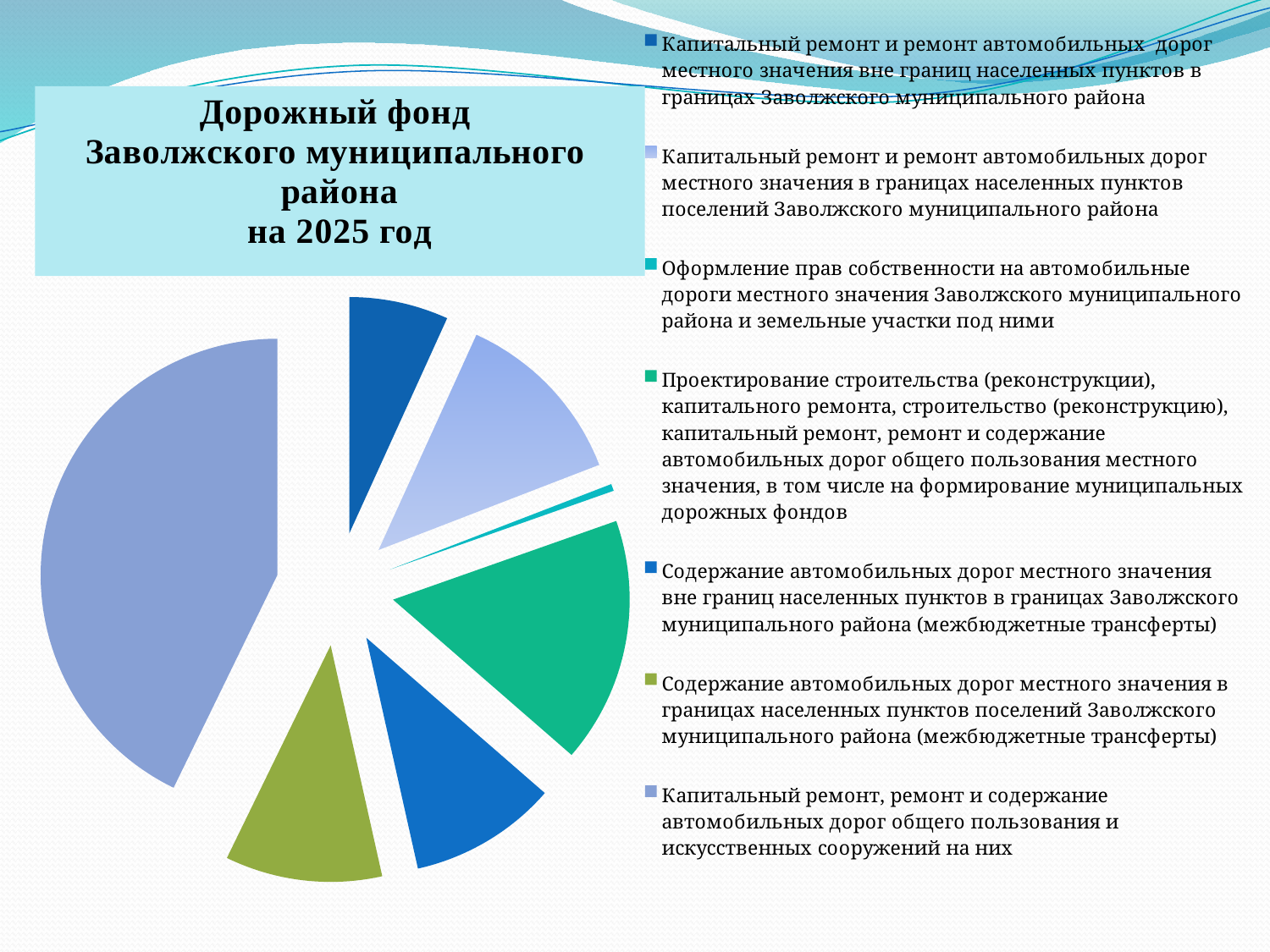
Which slice is larger: 'Капитальный ремонт, ремонт и содержание автомобильных дорог общего пользования и искусственных сооружений на них' or 'Проектирование строительства (реконструкции)...'? Капитальный ремонт, ремонт и содержание автомобильных дорог общего пользования и искусственных сооружений на них Which category has the smallest slice in the pie chart? Оформление прав собственности на автомобильные дороги местного значения Заволжского муниципального района и земельные участки под ними Which year does the chart title refer to? 2025 How many entries does the legend of the pie chart list? 7 What kind of chart is shown on the slide? Pie chart Which slice is larger: 'Содержание автомобильных дорог местного значения в границах населенных пунктов поселений... (межбюджетные трансферты)' or 'Оформление прав собственности...'? Содержание автомобильных дорог местного значения в границах населенных пунктов поселений... (межбюджетные трансферты) Which category has the largest slice in the pie chart? Капитальный ремонт, ремонт и содержание автомобильных дорог общего пользования и искусственных сооружений на них How many slices does the pie chart have? 7 What is the title of the chart on the slide? Дорожный фонд Заволжского муниципального района на 2025 год Which slice is larger: the one for 'Проектирование строительства (реконструкции)...' or the one for 'Оформление прав собственности...'? Проектирование строительства (реконструкции)...